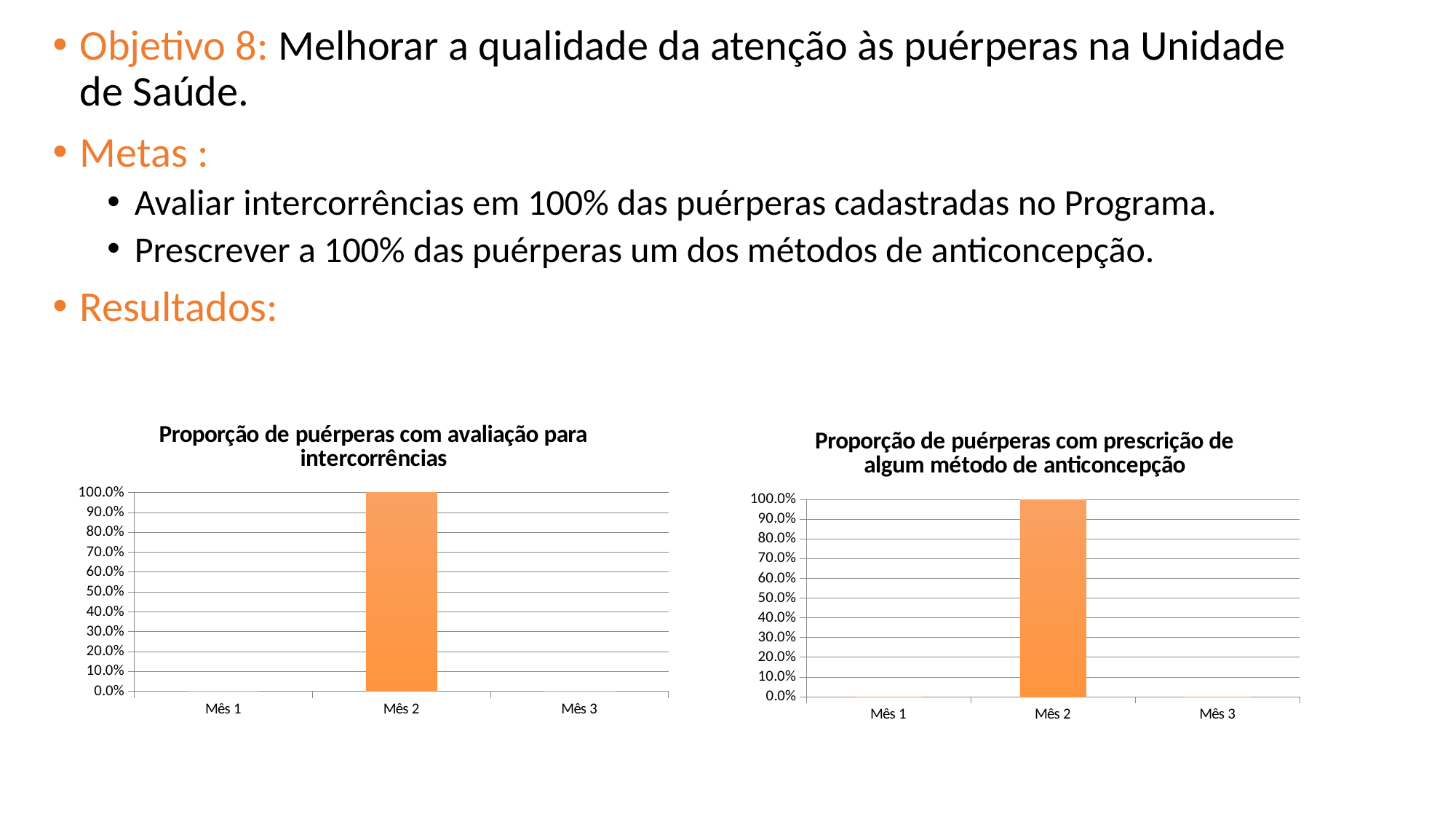
How many categories are shown on the x axis of the right chart? 3 How many charts are on the slide? 2 In the left chart, which month has the highest value? Mês 2 In the chart titled 'Proporção de puérperas com prescrição de algum método de anticoncepção', what is the value for Mês 2? 100.0% What is the title of the right chart? Proporção de puérperas com prescrição de algum método de anticoncepção In the right chart, is the value for Mês 3 greater or less than 20.0%? less In the left chart, is the value for Mês 2 greater or less than 50.0%? greater In the right chart, is the value for Mês 1 greater or less than 10.0%? less What kind of chart is the left chart? Bar chart In the left chart, which is larger, the value for Mês 2 or the value for Mês 3? Mês 2 In the right chart, which month has the highest value? Mês 2 In the chart titled 'Proporção de puérperas com avaliação para intercorrências', what is the value for Mês 2? 100.0%